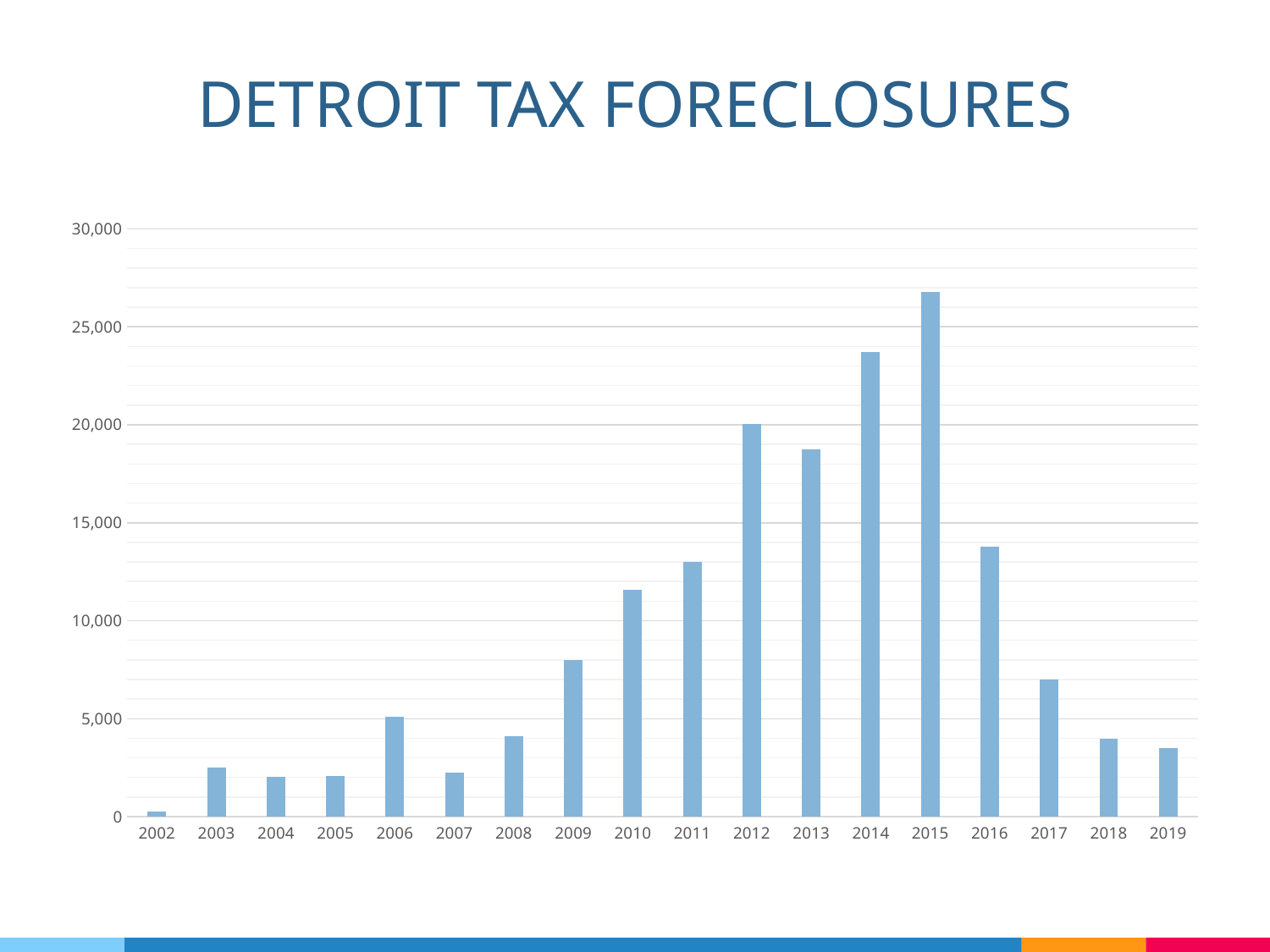
Which year has more tax foreclosures, 2013 or 2014? 2014 Which year has the highest number of tax foreclosures? 2015 What kind of chart is shown on the slide? Bar chart What is the title of the chart? DETROIT TAX FORECLOSURES Is the value for 2016 greater or less than 15,000? less Is the value for 2013 greater or less than 20,000? less Is the value for 2010 greater or less than 10,000? greater Do the values rise or fall from 2015 to 2019? fall How many years are shown on the x axis? 18 Which year has more tax foreclosures, 2016 or 2017? 2016 Which year has the lowest number of tax foreclosures? 2002